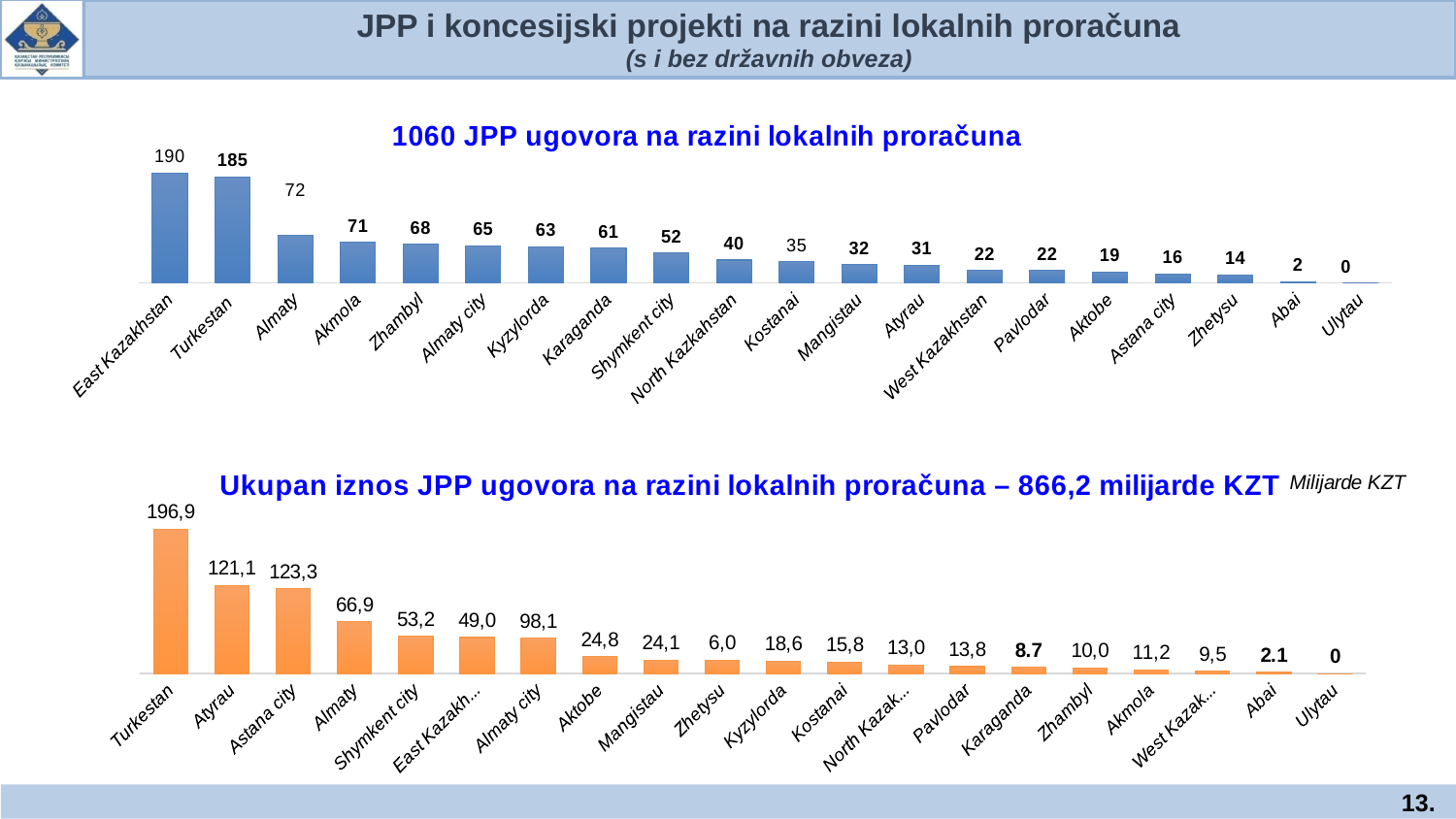
In the top chart '1060 JPP ugovora na razini lokalnih proračuna', what is the value for Turkestan? 185 In the top chart '1060 JPP ugovora na razini lokalnih proračuna', what is the difference between the values for East Kazakhstan and Almaty? 118 In the bottom chart 'Ukupan iznos JPP ugovora na razini lokalnih proračuna', which region has the highest value? Turkestan In the bottom chart 'Ukupan iznos JPP ugovora na razini lokalnih proračuna', which is larger, the value for Aktobe or the value for Zhetysu? Aktobe In the top chart '1060 JPP ugovora na razini lokalnih proračuna', which region has the lowest value? Ulytau In the bottom chart 'Ukupan iznos JPP ugovora na razini lokalnih proračuna', what is the difference between the values for Turkestan and Atyrau? 75,8 In the bottom chart 'Ukupan iznos JPP ugovora na razini lokalnih proračuna', what is the value for Astana city? 123,3 What unit is indicated for the bottom chart 'Ukupan iznos JPP ugovora na razini lokalnih proračuna'? Milijarde KZT In the top chart '1060 JPP ugovora na razini lokalnih proračuna', which is larger, the value for Kostanai or the value for Atyrau? Kostanai What kind of chart is the top chart '1060 JPP ugovora na razini lokalnih proračuna'? Bar chart In the top chart '1060 JPP ugovora na razini lokalnih proračuna', which region has the highest value? East Kazakhstan How many regions are shown in the top chart '1060 JPP ugovora na razini lokalnih proračuna'? 20